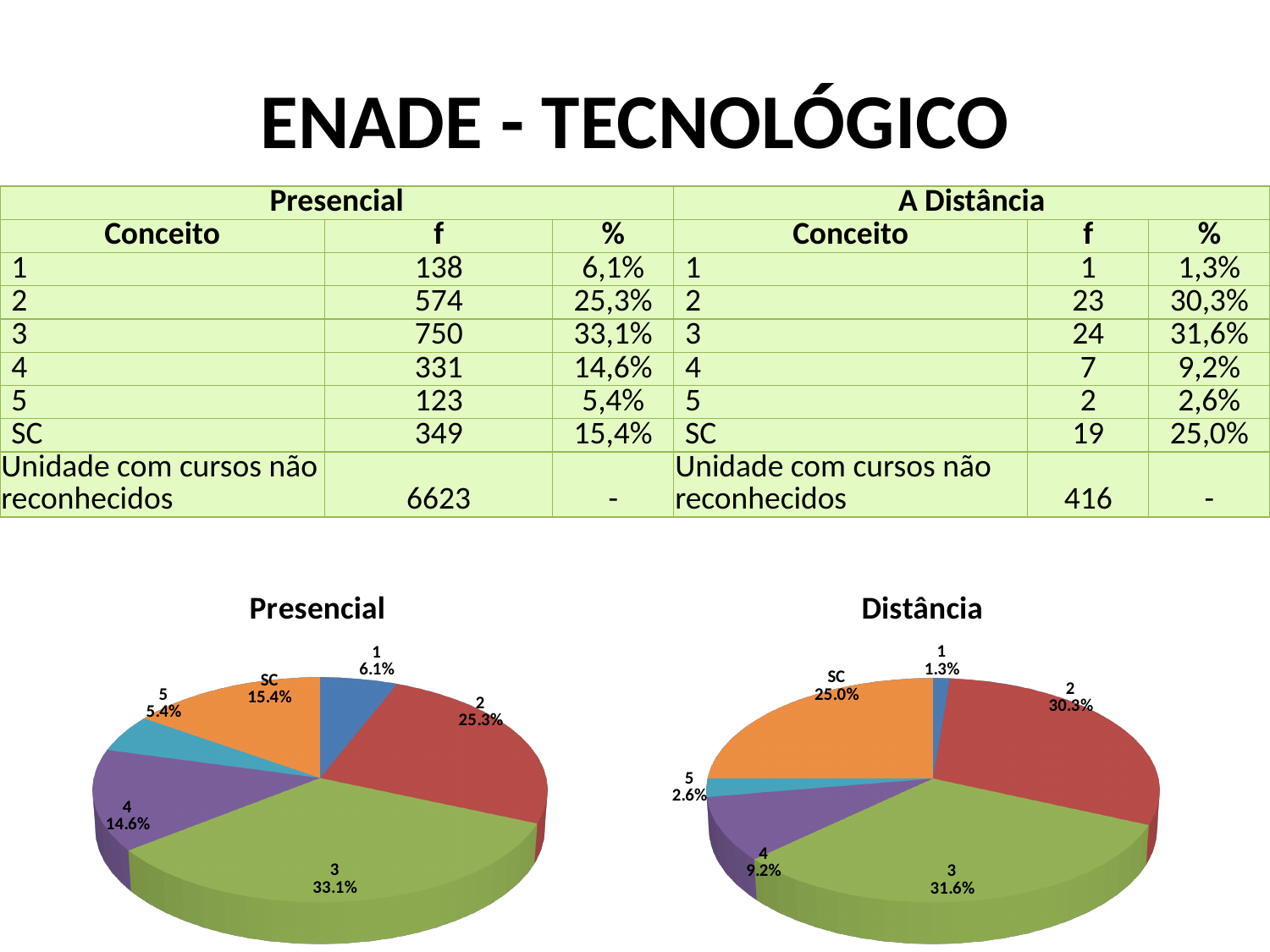
In the "Presencial" pie chart, what is the difference in percentage points between slice 3 and slice 2? 7.8 In the "Presencial" pie chart, which slice has the largest share? 3 In the "Presencial" pie chart, which slice has the smallest share? 5 In the "Presencial" pie chart, what percentage is shown for slice SC? 15.4% How many pie charts are shown on the slide? 2 In the "Distância" pie chart, what percentage is shown for slice 2? 30.3% What type of chart is the "Presencial" chart? pie chart In the "Distância" pie chart, what percentage is shown for slice 4? 9.2% How many slices does the "Distância" pie chart have? 6 In the "Distância" pie chart, which is larger: slice 2 or slice SC? 2 In the "Presencial" pie chart, what percentage is shown for slice 3? 33.1% In the "Distância" pie chart, which slice has the smallest share? 1